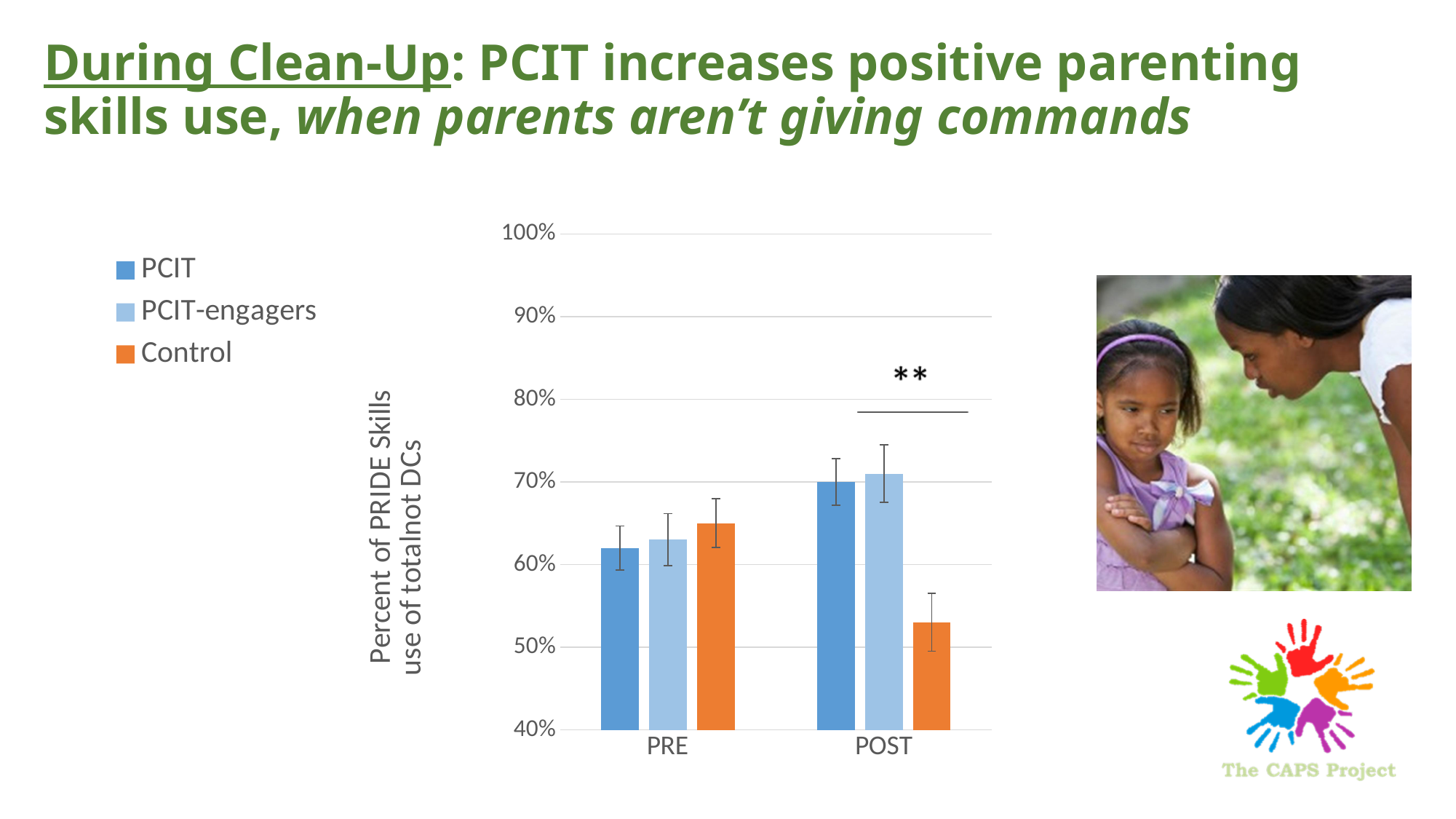
Is the value for PCIT-engagers at POST greater or less than 80%? less How many categories are shown on the x axis? 2 How many series does the legend list? 3 Which series is shown in orange in the legend? Control Is the value for Control at PRE greater or less than 60%? greater What is the label of the y axis? Percent of PRIDE Skills use of totalnot DCs What kind of chart is shown on the slide? bar chart Is the value for PCIT at POST greater or less than 60%? greater At POST, which is larger, the value for PCIT or the value for Control? PCIT Does the value for Control rise or fall from PRE to POST? fall Which series has the lowest value at POST? Control